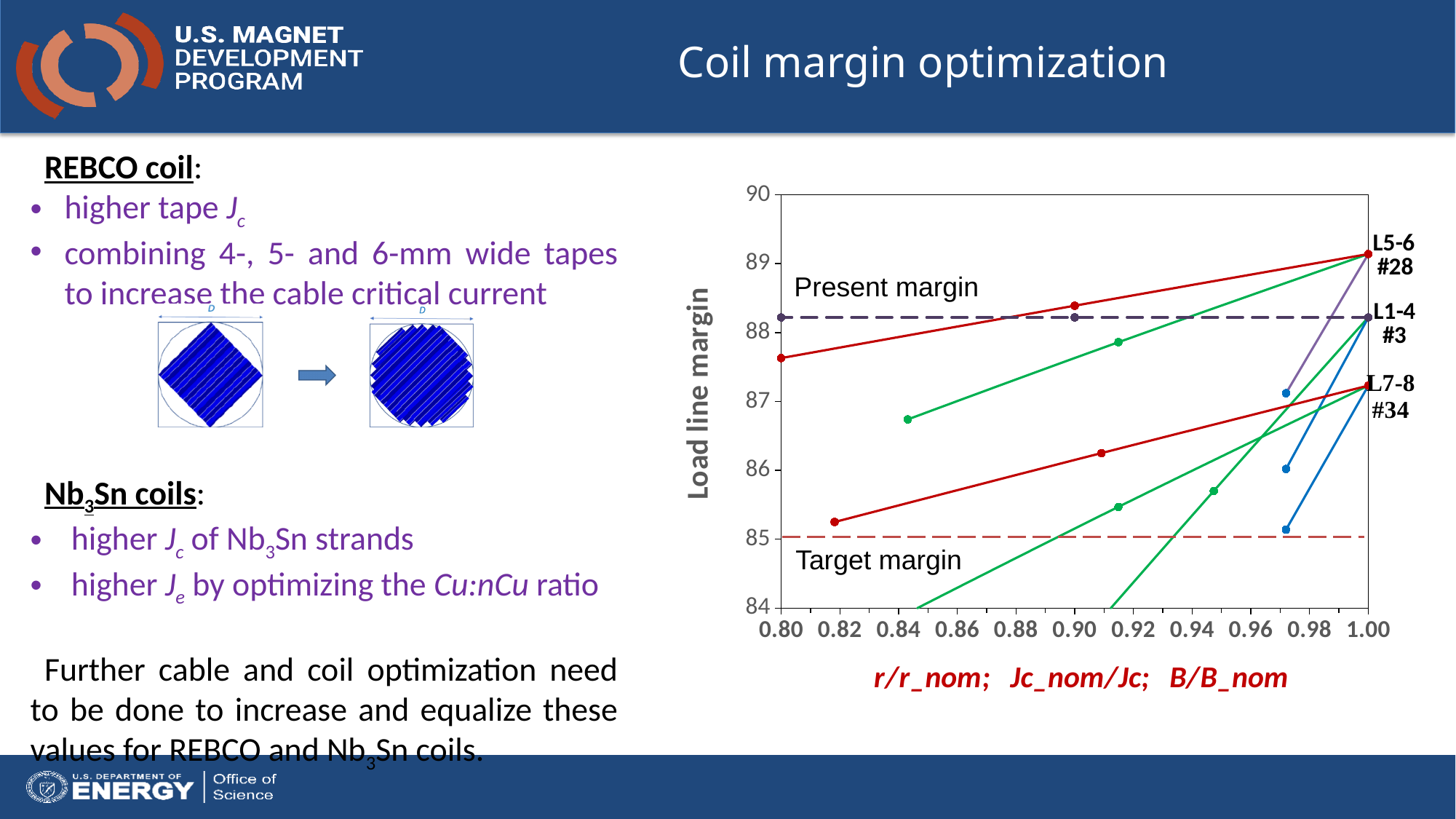
Is the Target margin dashed line greater or less than 86? less How many labeled coil groups (L5-6 #28, L1-4 #3, L7-8 #34) are marked on the chart? 3 What is the label of the x axis of the chart? r/r_nom; Jc_nom/Jc; B/B_nom Which labeled coil group has the lowest load line margin at x = 1.00? L7-8 #34 What kind of chart is shown on the slide? line chart Is the load line margin of L7-8 #34 at x = 1.00 greater or less than 88? less At x = 1.00, which has the larger load line margin, L1-4 #3 or L7-8 #34? L1-4 #3 Which labeled coil group has the highest load line margin at x = 1.00? L5-6 #28 Do the plotted lines rise or fall as the x-axis value increases from 0.80 to 1.00? rise Is the Present margin dashed line greater or less than 88? greater What is the label of the y axis of the chart? Load line margin